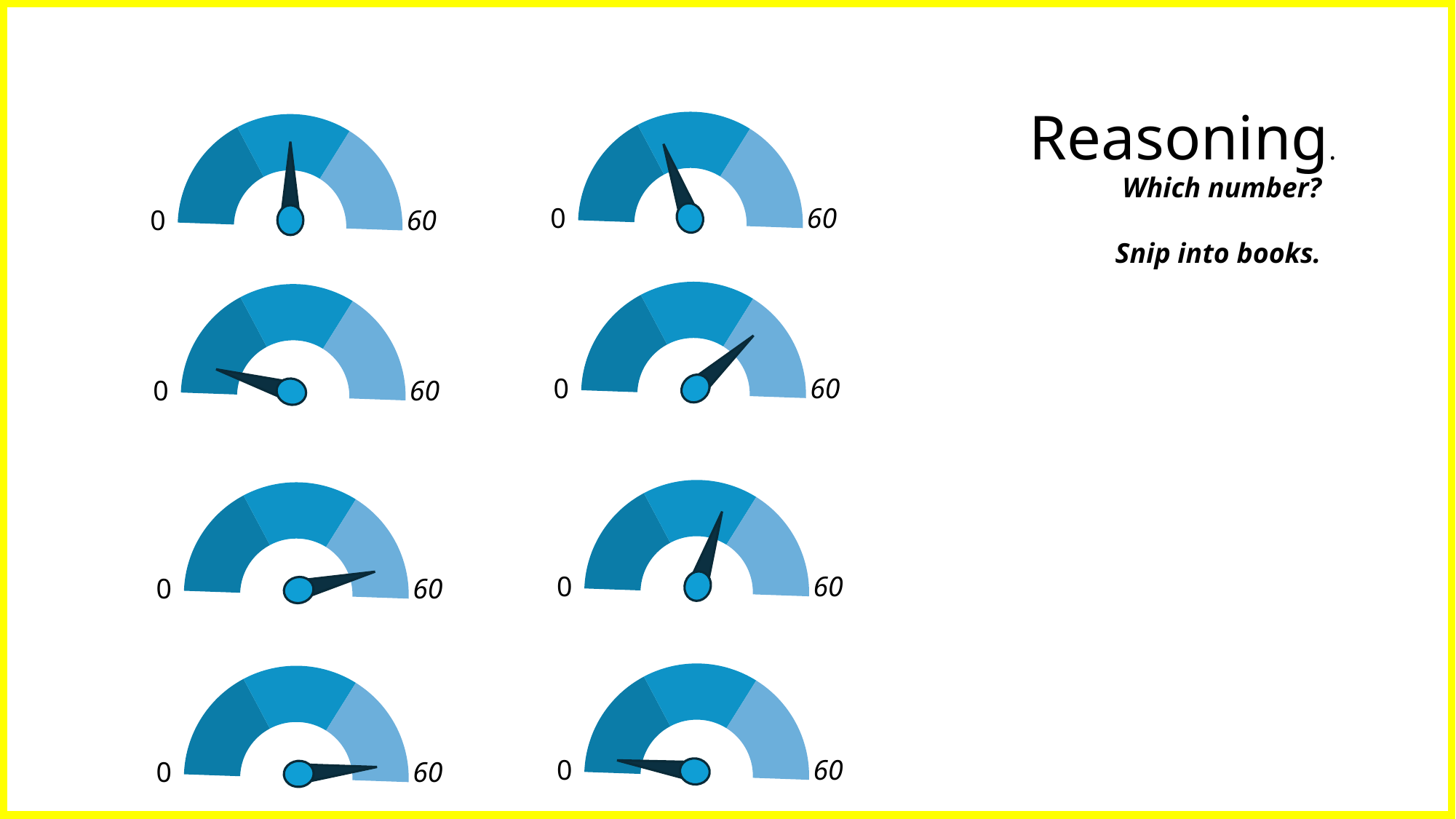
Comparing the two gauges in the second row, which one has the needle pointing to the larger value, the left or the right? Right Which gauge shows the larger value: the top-right gauge or the right gauge in the second row? The right gauge in the second row What is the maximum value printed on the scale of each gauge? 60 Is the needle on the bottom-right gauge closer to 0 or to 60? 0 Which gauge shows the smaller value: the right gauge in the third row or the bottom-right gauge? The bottom-right gauge What kind of chart is shown in the top-left position on the slide? Gauge chart Is the needle on the left gauge in the second row closer to 0 or to 60? 0 How many gauge charts are shown on the slide? 8 What is the minimum value printed on the scale of each gauge? 0 Is the needle on the bottom-left gauge closer to 0 or to 60? 60